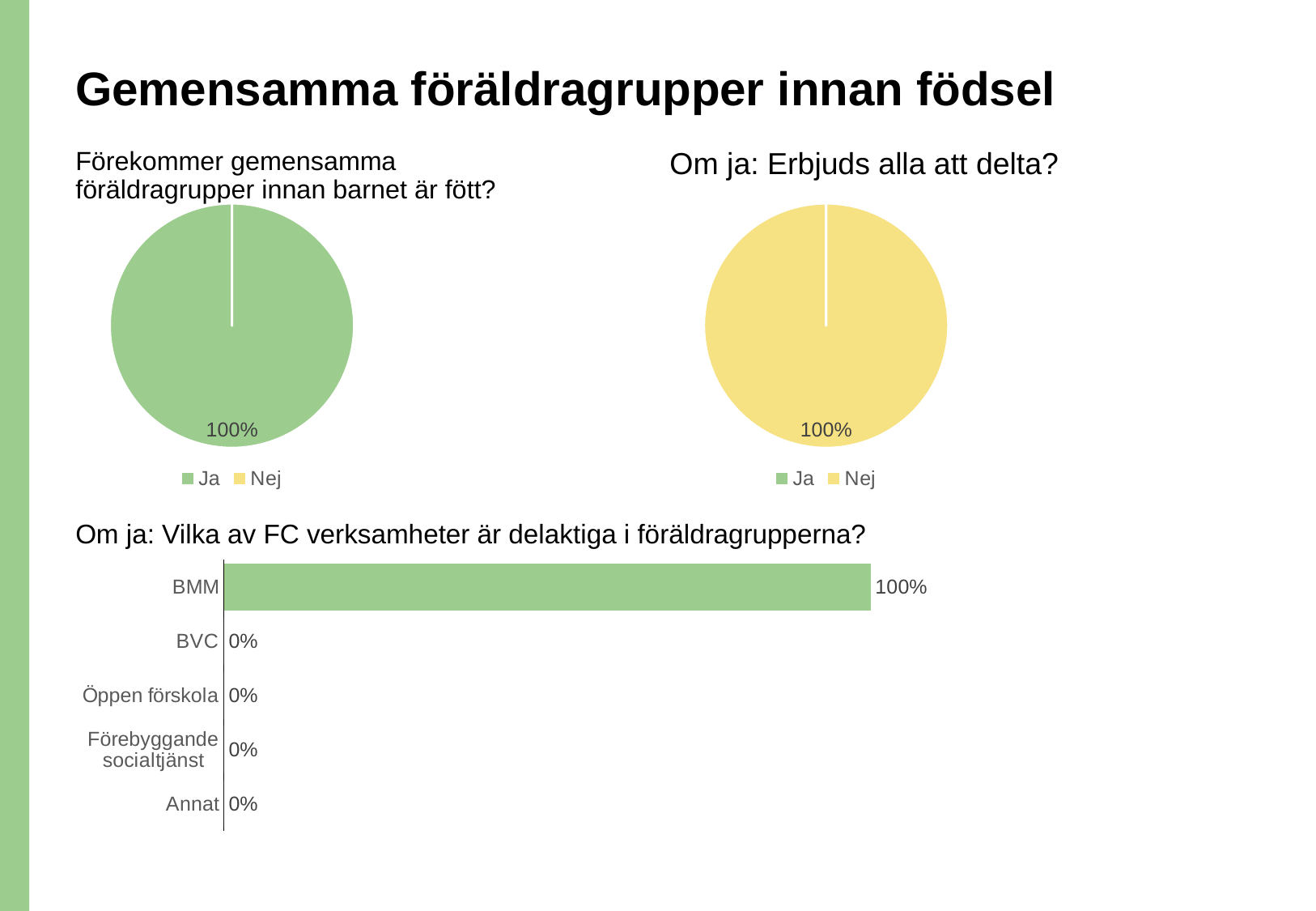
In the pie chart 'Om ja: Erbjuds alla att delta?', what share does the Nej slice have? 100% In the pie chart 'Förekommer gemensamma föräldragrupper innan barnet är fött?', what share does the Ja slice have? 100% In the bar chart 'Om ja: Vilka av FC verksamheter är delaktiga i föräldragrupperna?', which is larger, the value for BMM or the value for BVC? BMM What kind of chart is 'Om ja: Vilka av FC verksamheter är delaktiga i föräldragrupperna?'? Bar chart In the bar chart 'Om ja: Vilka av FC verksamheter är delaktiga i föräldragrupperna?', what is the difference between the values for BMM and Annat? 100% In the bar chart 'Om ja: Vilka av FC verksamheter är delaktiga i föräldragrupperna?', what is the value for BVC? 0% In the bar chart 'Om ja: Vilka av FC verksamheter är delaktiga i föräldragrupperna?', how many categories are shown? 5 In the bar chart 'Om ja: Vilka av FC verksamheter är delaktiga i föräldragrupperna?', what is the value for Öppen förskola? 0% How many series does the legend of the pie chart 'Om ja: Erbjuds alla att delta?' list? 2 In the bar chart 'Om ja: Vilka av FC verksamheter är delaktiga i föräldragrupperna?', which category has the highest value? BMM In the bar chart 'Om ja: Vilka av FC verksamheter är delaktiga i föräldragrupperna?', what is the value for BMM? 100% What kind of chart is 'Förekommer gemensamma föräldragrupper innan barnet är fött?'? Pie chart